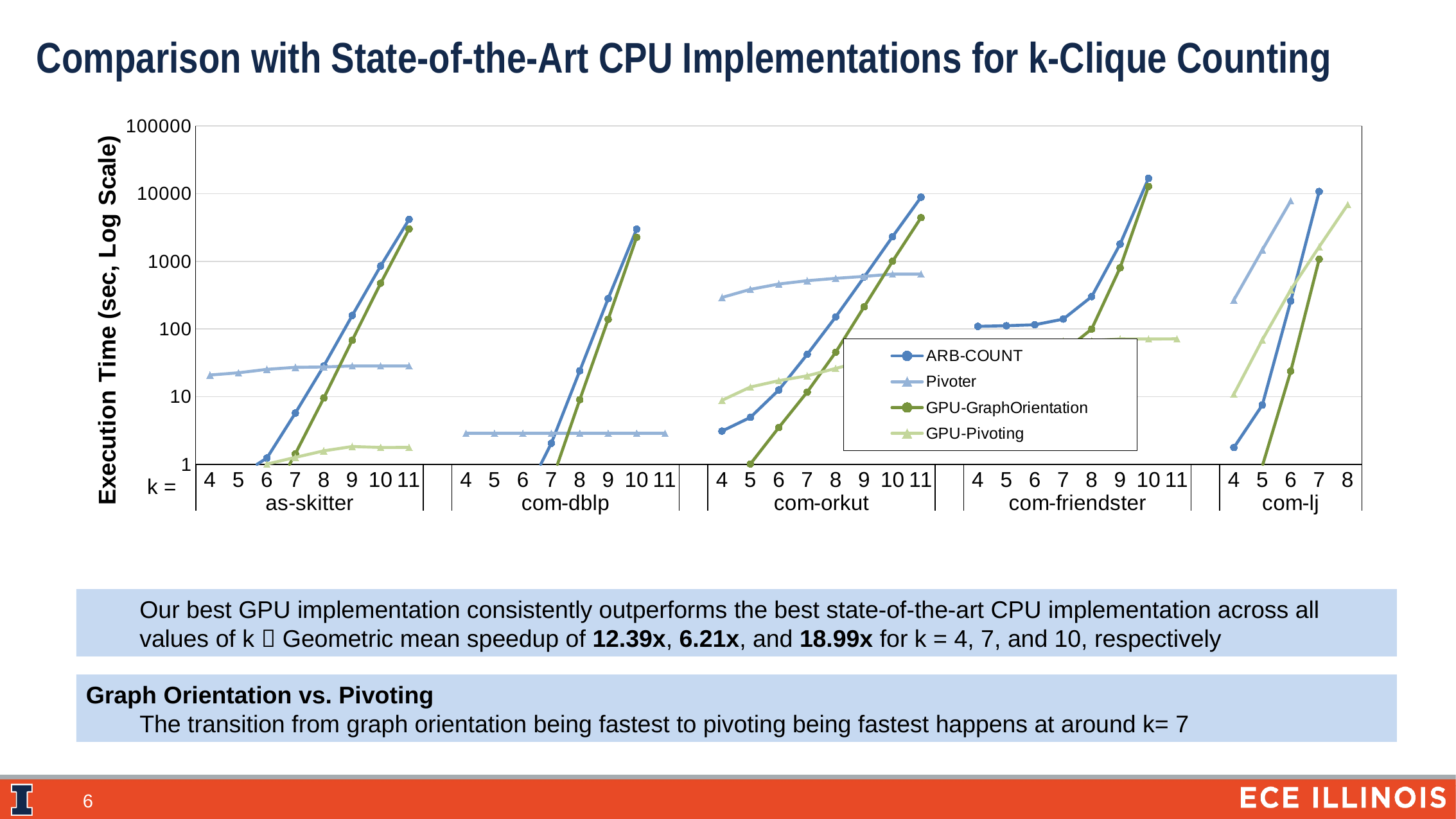
Is the Pivoter value for com-dblp at k = 4 greater or less than 10? less For com-lj at k = 6, which is higher: Pivoter or ARB-COUNT? Pivoter How many graph datasets are shown along the x axis? 5 Does the ARB-COUNT execution time for com-orkut rise or fall as k increases? rise What kind of chart is shown on the slide? line chart Is the GPU-Pivoting value for as-skitter at k = 11 greater or less than 10? less Is the Pivoter value for com-orkut at k = 4 greater or less than 100? greater How many series does the legend list? 4 What are the four series named in the legend? ARB-COUNT, Pivoter, GPU-GraphOrientation, GPU-Pivoting For as-skitter at k = 9, which is higher: ARB-COUNT or GPU-GraphOrientation? ARB-COUNT What is the label of the y axis? Execution Time (sec, Log Scale)